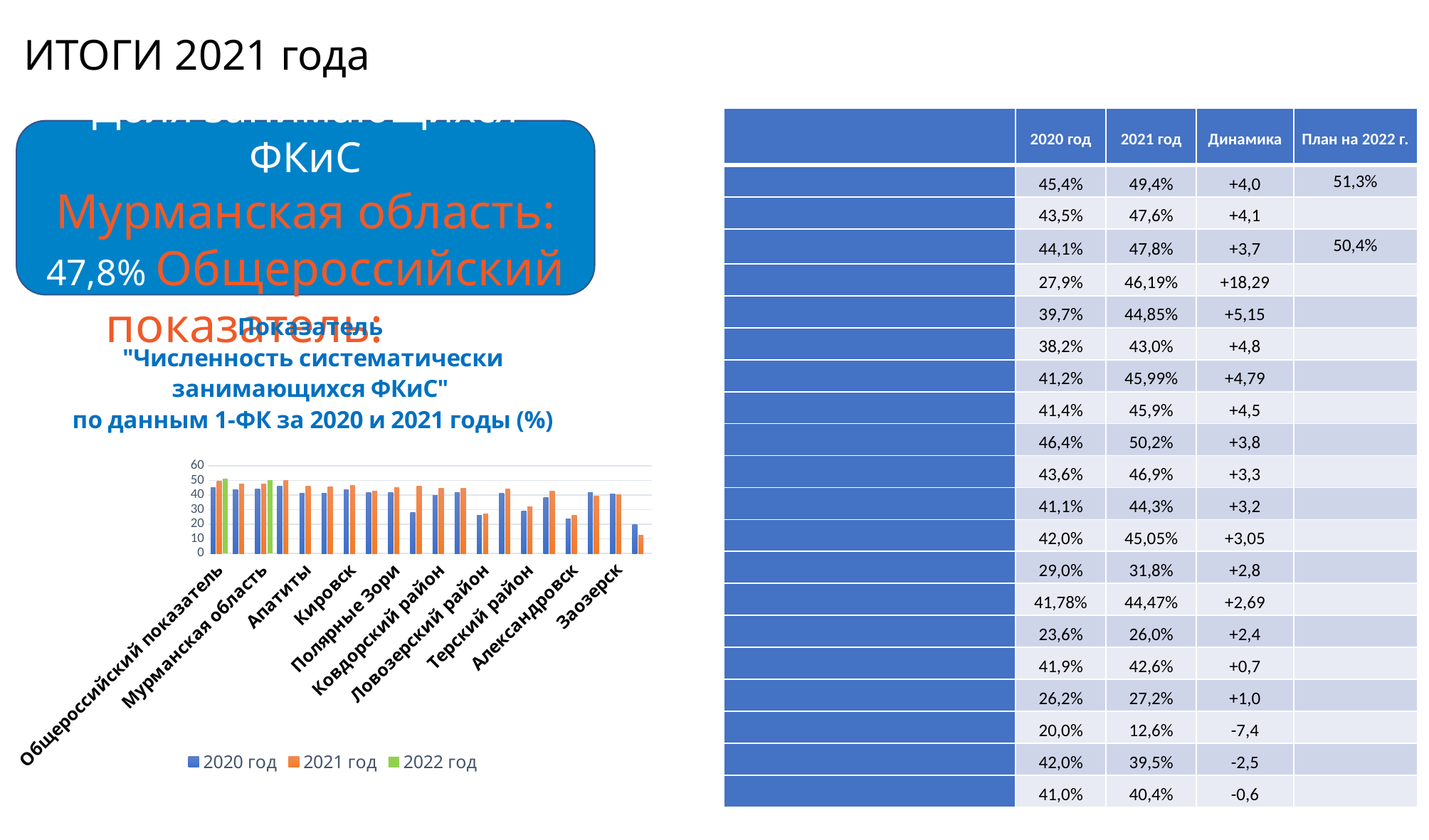
Which two categories have a bar for the 2022 год series? Общероссийский показатель and Мурманская область Is the 2021 год value for Ковдорский район greater or less than 40? greater How many series does the chart legend list? 3 Is the 2020 год value for Ловозерский район greater or less than 30? less For Заозерск, which is larger: the 2020 год value or the 2021 год value? 2020 год Is the 2021 год value for Заозерск greater or less than 20? greater For Ковдорский район, which is larger: the 2020 год value or the 2021 год value? 2021 год What kind of chart is shown on the slide? bar chart Which series in the chart is shown with green bars? 2022 год